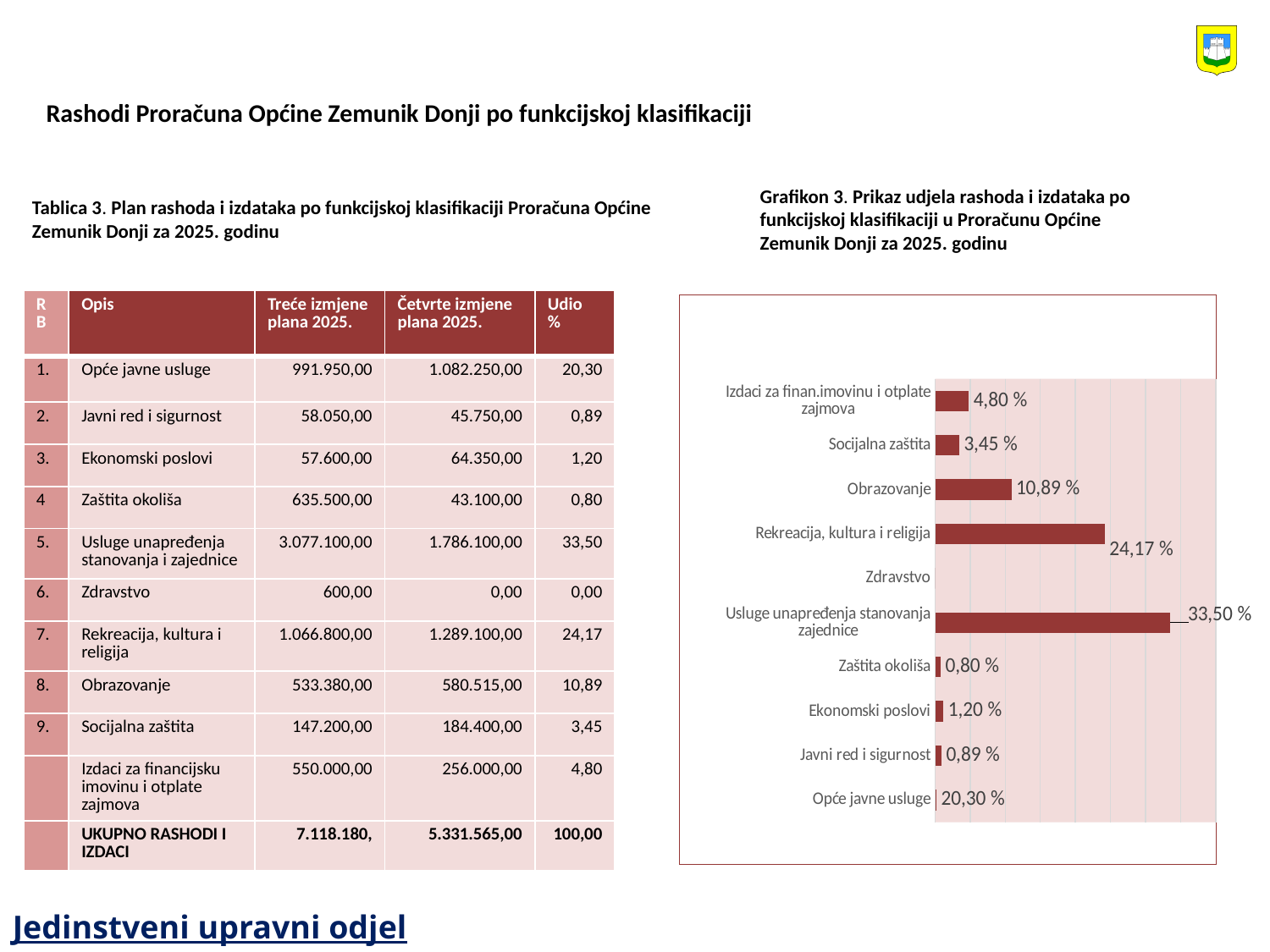
In the chart, what is the value for Rekreacija, kultura i religija? 24,17 % What kind of chart is shown in Grafikon 3 on the slide? bar chart In the chart, what is the value for Izdaci za finan.imovinu i otplate zajmova? 4,80 % In the chart, what is the difference between the values for Usluge unapređenja stanovanja zajednice and Rekreacija, kultura i religija? 9,33 % What is the title of the chart on the slide? Grafikon 3. Prikaz udjela rashoda i izdataka po funkcijskoj klasifikaciji u Proračunu Općine Zemunik Donji za 2025. godinu In the chart, what is the value for Socijalna zaštita? 3,45 % In the chart, what is the difference between the values for Izdaci za finan.imovinu i otplate zajmova and Socijalna zaštita? 1,35 % In the chart, what is the value for Zaštita okoliša? 0,80 % How many categories are shown in the chart? 10 In the chart, what is the value for Obrazovanje? 10,89 % Which category has the highest value in the chart? Usluge unapređenja stanovanja zajednice In the chart, which is larger: the value for Obrazovanje or the value for Socijalna zaštita? Obrazovanje